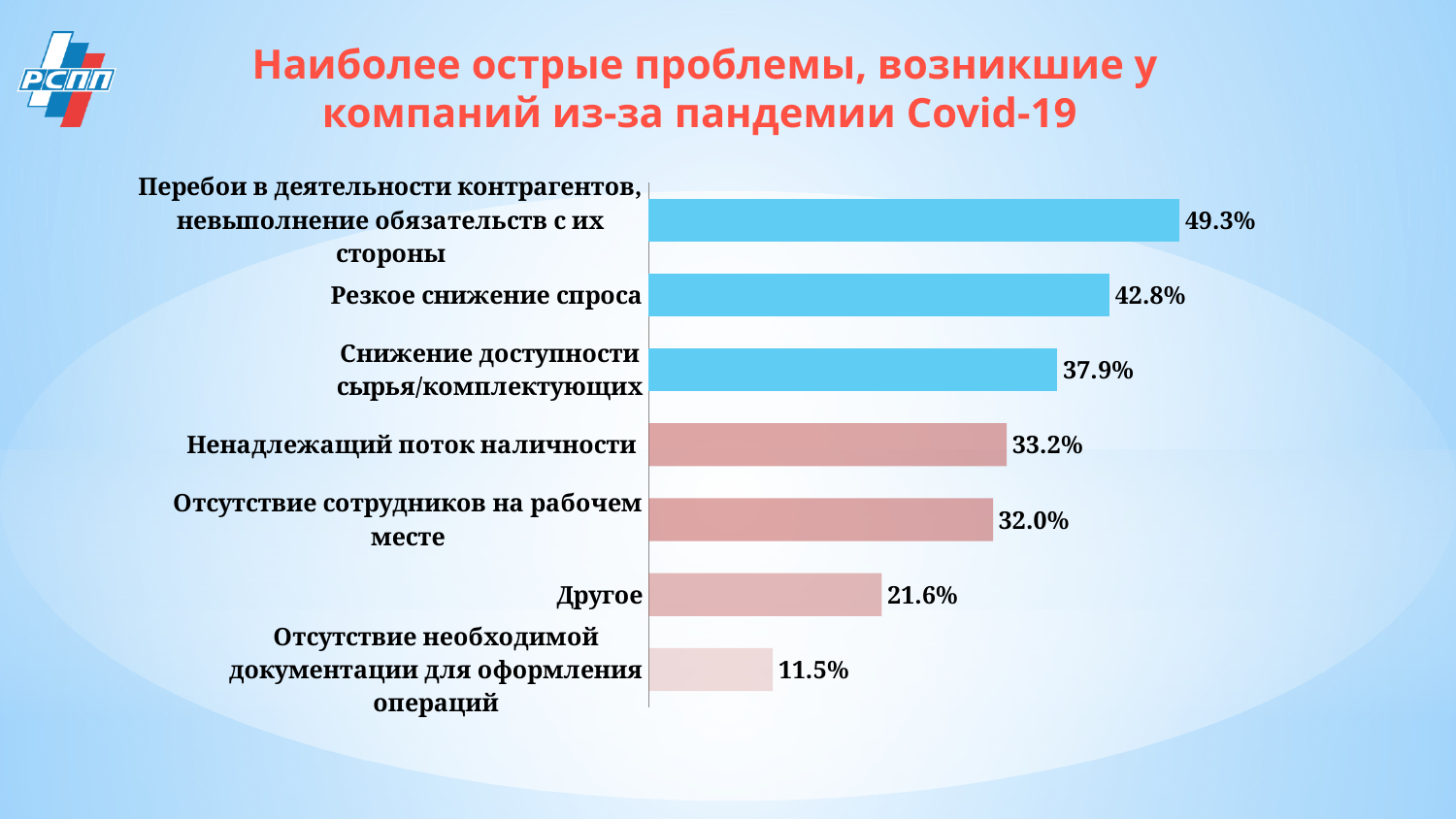
What is the value for «Резкое снижение спроса»? 42.8% What is the value for «Другое»? 21.6% What is the difference between the values for «Резкое снижение спроса» and «Снижение доступности сырья/комплектующих»? 4.9% Which category has the highest value? Перебои в деятельности контрагентов, невыполнение обязательств с их стороны What is the difference between the values for «Другое» and «Отсутствие необходимой документации для оформления операций»? 10.1% Which is larger: the value for «Ненадлежащий поток наличности» or for «Отсутствие сотрудников на рабочем месте»? Ненадлежащий поток наличности What is the value for «Ненадлежащий поток наличности»? 33.2% How many categories are shown in the chart? 7 What is the value for «Отсутствие сотрудников на рабочем месте»? 32.0% Which category has the lowest value? Отсутствие необходимой документации для оформления операций What kind of chart is shown on the slide? Bar chart What is the title of the slide? Наиболее острые проблемы, возникшие у компаний из-за пандемии Covid-19